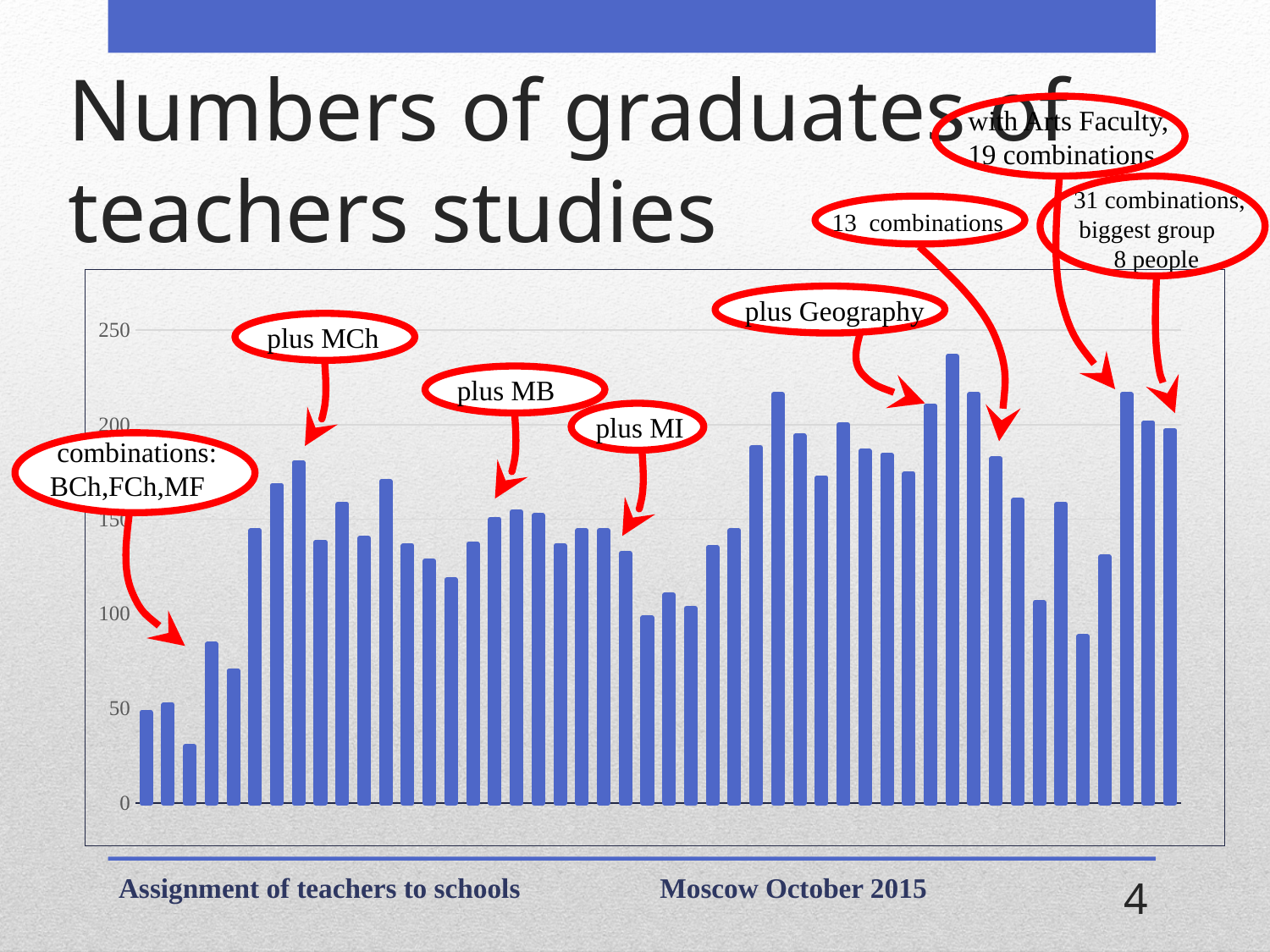
Is the value of the third bar from the left greater or less than 50? less What is the highest value labelled on the vertical axis of the chart? 250 Which is taller, the leftmost bar or the rightmost bar? the rightmost bar What kind of chart is shown on the slide? bar chart Is the value of the leftmost bar greater or less than 100? less Do the bar values generally rise or fall from left to right across the chart? rise Which bar is the lowest in the chart? the third bar from the left What is the title of the slide containing the chart? Numbers of graduates of teachers studies Is the value of the tallest bar greater or less than 200? greater